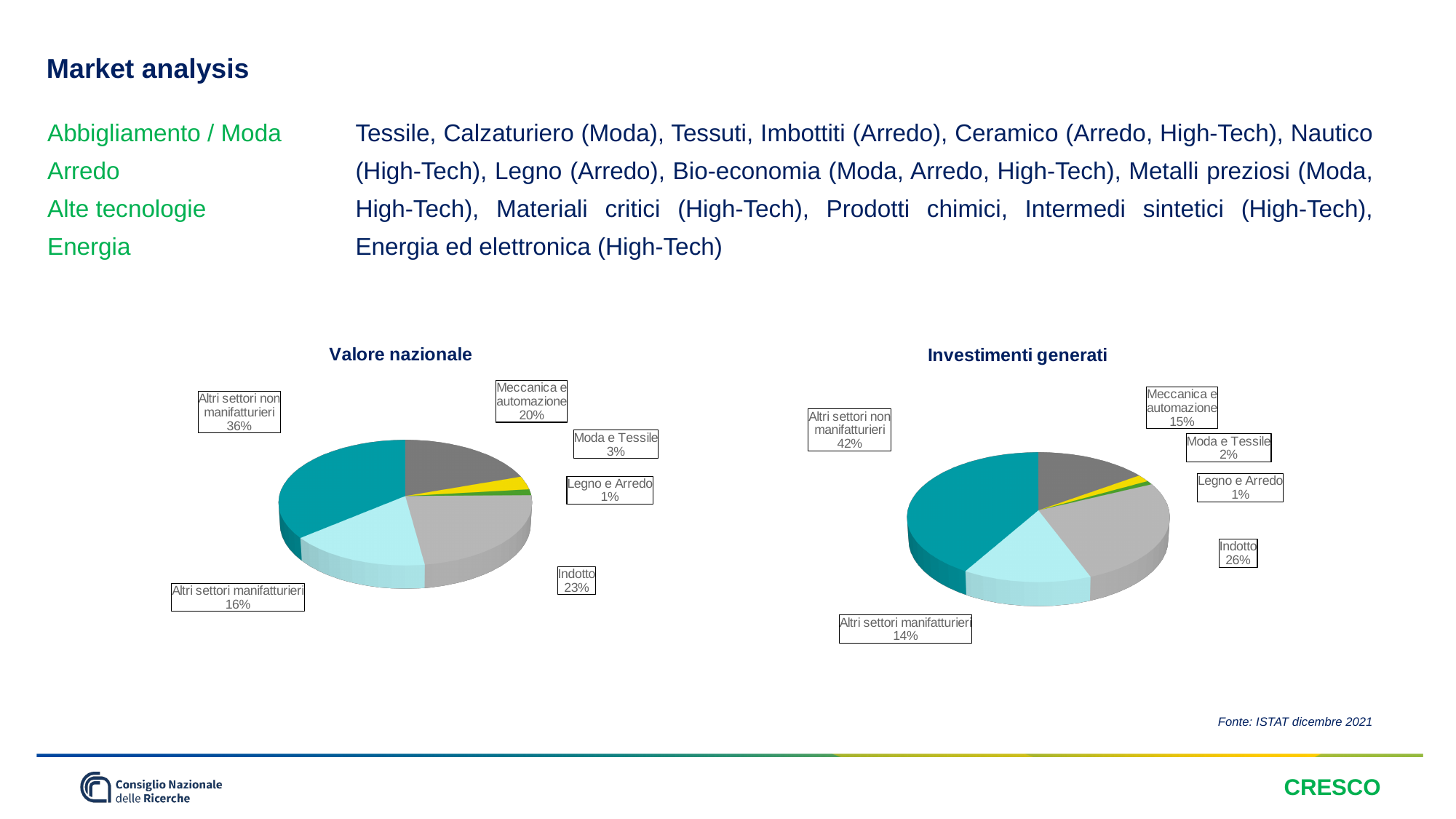
In the 'Investimenti generati' chart, what share does 'Meccanica e automazione' have? 15% What type of chart is 'Investimenti generati'? Pie chart What source is cited for the charts on the slide? Fonte: ISTAT dicembre 2021 How many categories are shown in the 'Valore nazionale' pie chart? 6 In the 'Valore nazionale' chart, what is the difference between the shares of 'Meccanica e automazione' and 'Altri settori manifatturieri'? 4 percentage points In the 'Valore nazionale' chart, what share does 'Moda e Tessile' have? 3% In the 'Investimenti generati' chart, which is larger: 'Indotto' or 'Altri settori manifatturieri'? Indotto In the 'Investimenti generati' chart, which category has the smallest share? Legno e Arredo In the 'Valore nazionale' chart, what share does 'Indotto' have? 23% What is the title of the pie chart on the left of the slide? Valore nazionale In the 'Investimenti generati' chart, what share does 'Altri settori non manifatturieri' have? 42% In the 'Valore nazionale' chart, which category has the largest share? Altri settori non manifatturieri